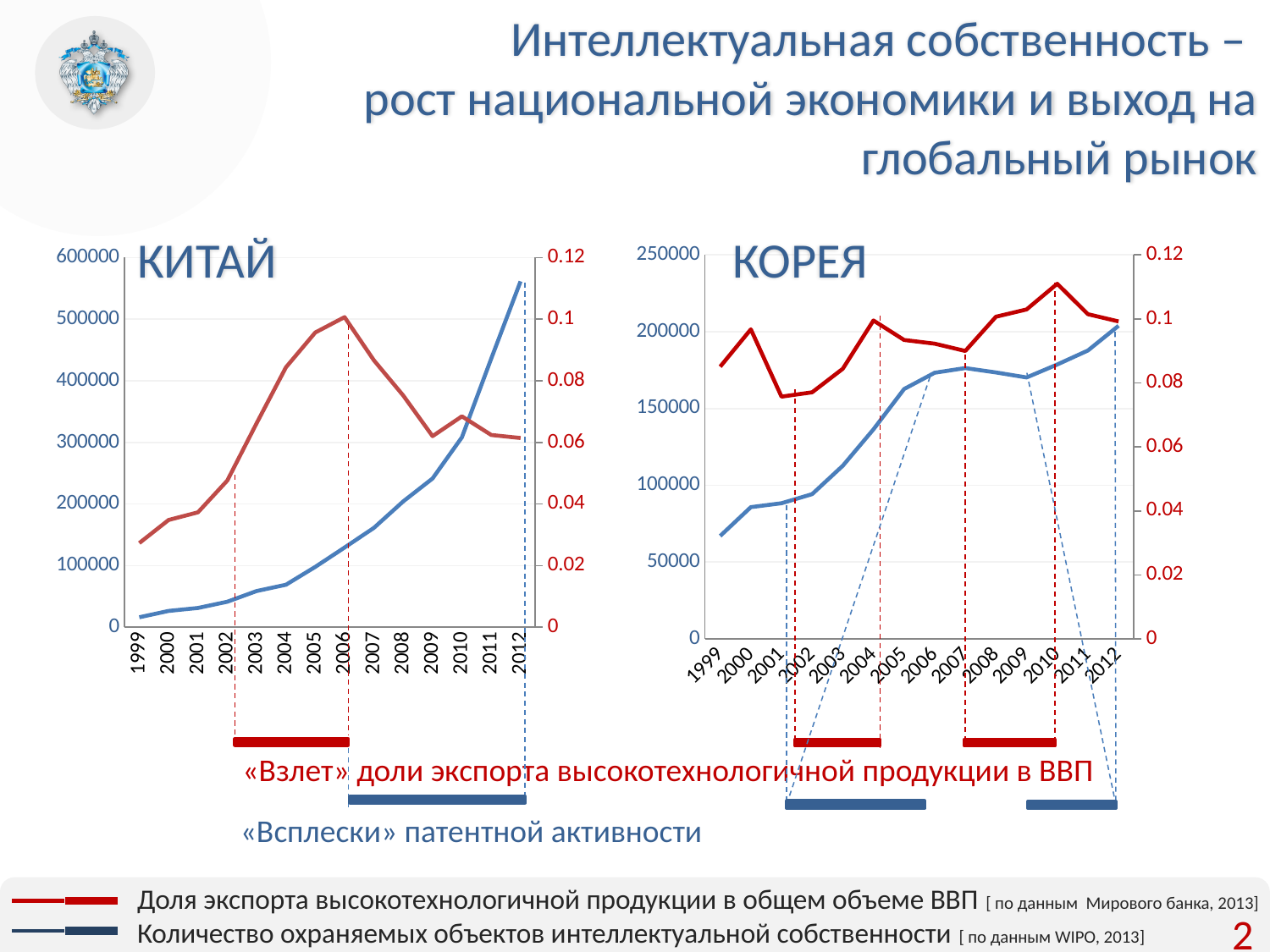
How many years are plotted on the x axis of the КОРЕЯ chart? 14 In the КИТАЙ chart, is the blue line's value for 2012 greater or less than 500000? greater In the КИТАЙ chart, in which year does the blue line (number of protected IP objects) reach its highest value? 2012 In the КИТАЙ chart, in which year is the blue line at its lowest? 1999 In the КОРЕЯ chart, which year has the larger blue-line value, 1999 or 2012? 2012 In the КИТАЙ chart, does the blue line generally rise or fall from 1999 to 2012? rise How many series does the legend at the bottom of the slide list? 2 In the КОРЕЯ chart, is the blue line's value for 2006 greater or less than 150000? greater What kind of chart is the КИТАЙ chart? line chart In the КИТАЙ chart, is the blue line's value for 2009 greater or less than 300000? less In the КИТАЙ chart, in which year does the red line (share of high-tech exports) reach its highest value? 2006 In the КОРЕЯ chart, in which year does the red line (share of high-tech exports) reach its highest value? 2010